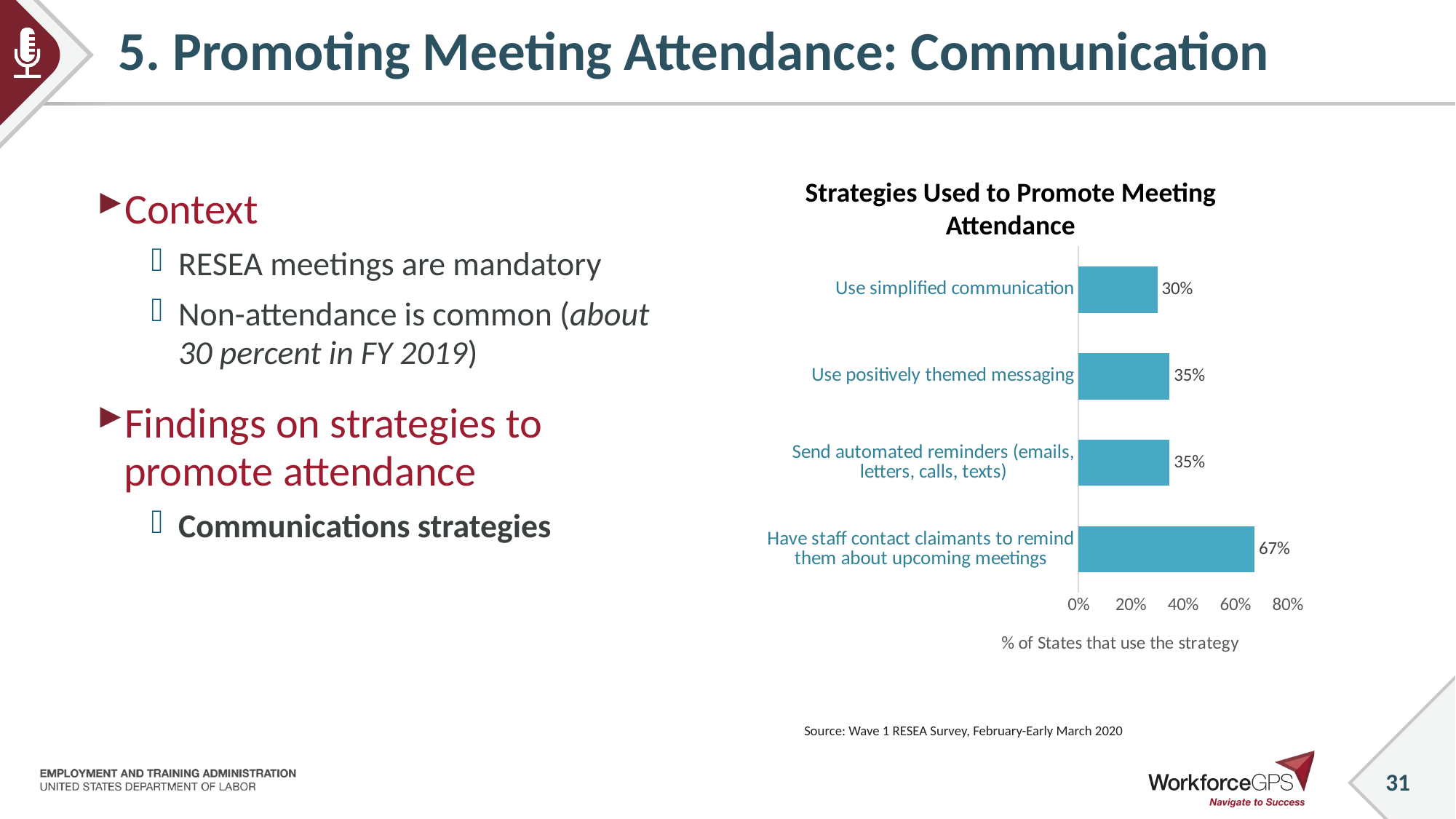
What is the difference in percentage points between having staff contact claimants and using simplified communication? 37 percentage points What percentage of States have staff contact claimants to remind them about upcoming meetings? 67% Which is larger: the percentage of States that send automated reminders or the percentage that use simplified communication? Send automated reminders (emails, letters, calls, texts) What is the title of the chart on the slide? Strategies Used to Promote Meeting Attendance How many strategies are shown in the chart? 4 What percentage of States use positively themed messaging? 35% Which strategy is used by the highest percentage of States? Have staff contact claimants to remind them about upcoming meetings What percentage of States use simplified communication to promote meeting attendance? 30% What does the horizontal axis of the chart measure? % of States that use the strategy Is the value for having staff contact claimants greater or less than 60%? greater What type of chart is used to show the strategies used to promote meeting attendance? Bar chart Which strategy is used by the lowest percentage of States? Use simplified communication